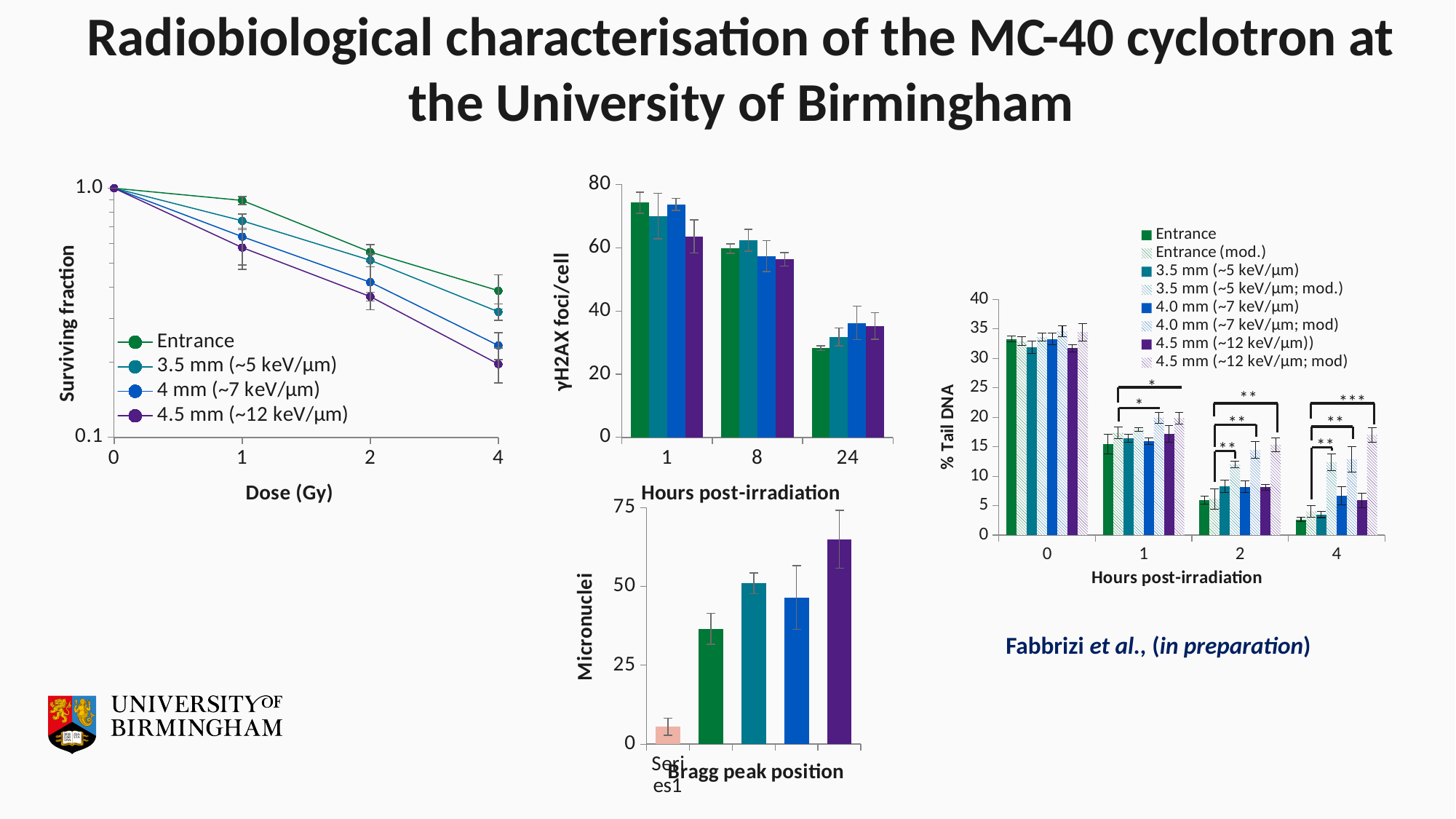
How many series does the legend of the % Tail DNA chart list? 8 In the Micronuclei chart, how many bars are plotted? 5 In the Micronuclei chart, is the tallest (purple) bar greater or less than 50? greater How many series does the legend of the Surviving fraction chart list? 4 In the γH2AX foci/cell chart, do the foci counts rise or fall from 1 to 24 hours post-irradiation? fall In the Surviving fraction chart, does the surviving fraction rise or fall as the dose increases? fall In the Surviving fraction chart, which series has the lowest surviving fraction at 4 Gy? 4.5 mm (~12 keV/µm) What kind of chart is the Surviving fraction chart on the left of the slide? line chart In the % Tail DNA chart, is the Entrance value at 4 hours post-irradiation greater or less than 5? less In the γH2AX foci/cell chart, is the Entrance value at 24 hours post-irradiation greater or less than 40? less In the γH2AX foci/cell chart, how many time-point categories are shown on the x axis? 3 What is the x-axis title of the Surviving fraction chart? Dose (Gy)